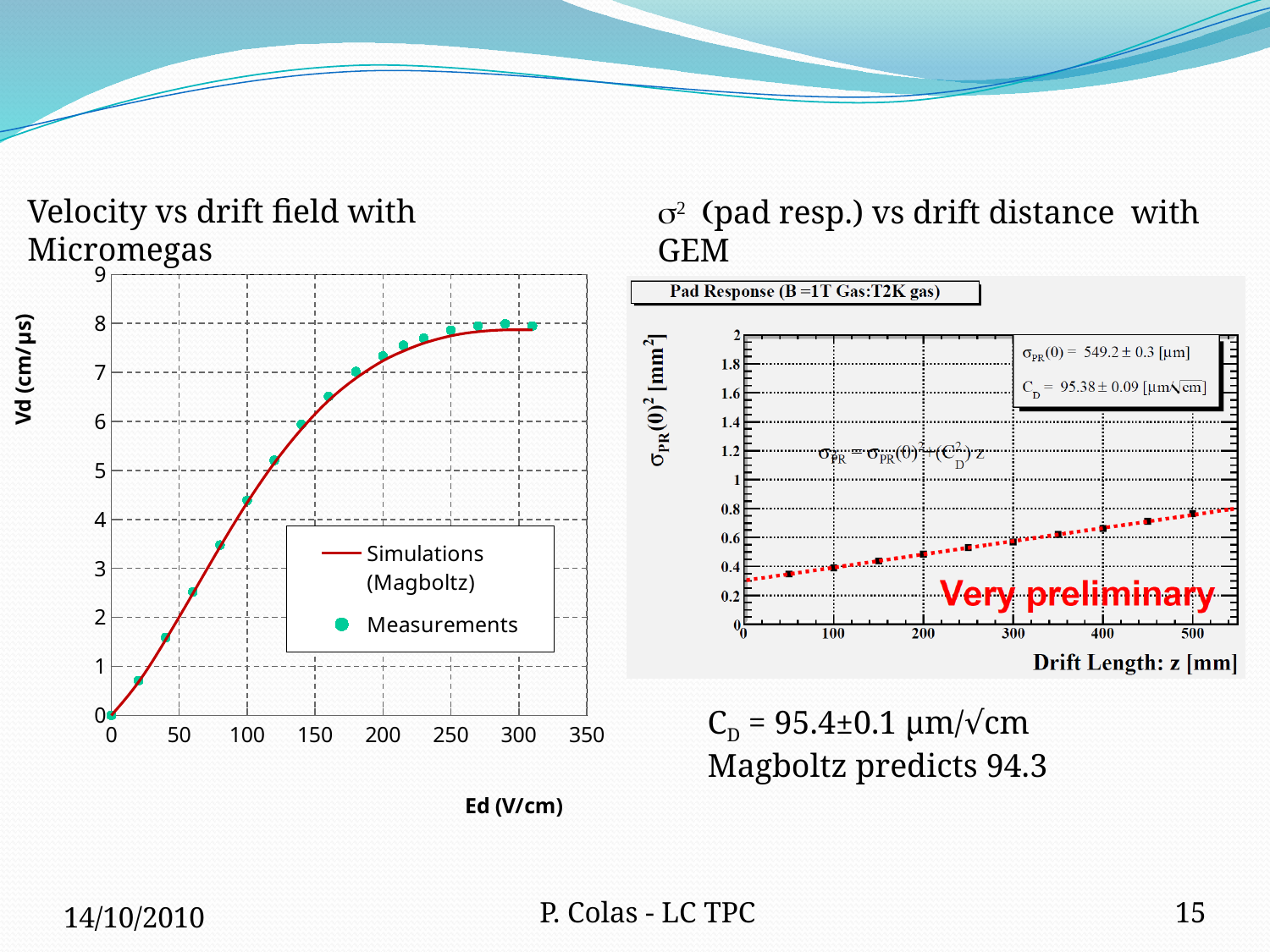
What is the title printed above the right chart? Pad Response (B =1T Gas:T2K gas) On the left chart, is the measured velocity at Ed = 300 V/cm greater or less than 7 cm/µs? greater On the left chart, is the measured velocity at Ed = 20 V/cm greater or less than 1 cm/µs? less On the right chart, is the value at drift length z = 500 mm greater or less than 0.6 mm²? greater How many series does the legend of the left chart list? 2 What are the two legend entries on the left chart? Simulations (Magboltz) and Measurements On the left chart, does the drift velocity rise or fall as Ed increases from 0 to 350 V/cm? rise On the left chart, which is larger: the measured velocity at Ed = 100 V/cm or at Ed = 300 V/cm? Ed = 300 V/cm On the right chart, at which drift length is the plotted σ_PR(0)² value highest? 500 mm What kind of chart is the left chart, 'Velocity vs drift field with Micromegas'? line chart with scatter points